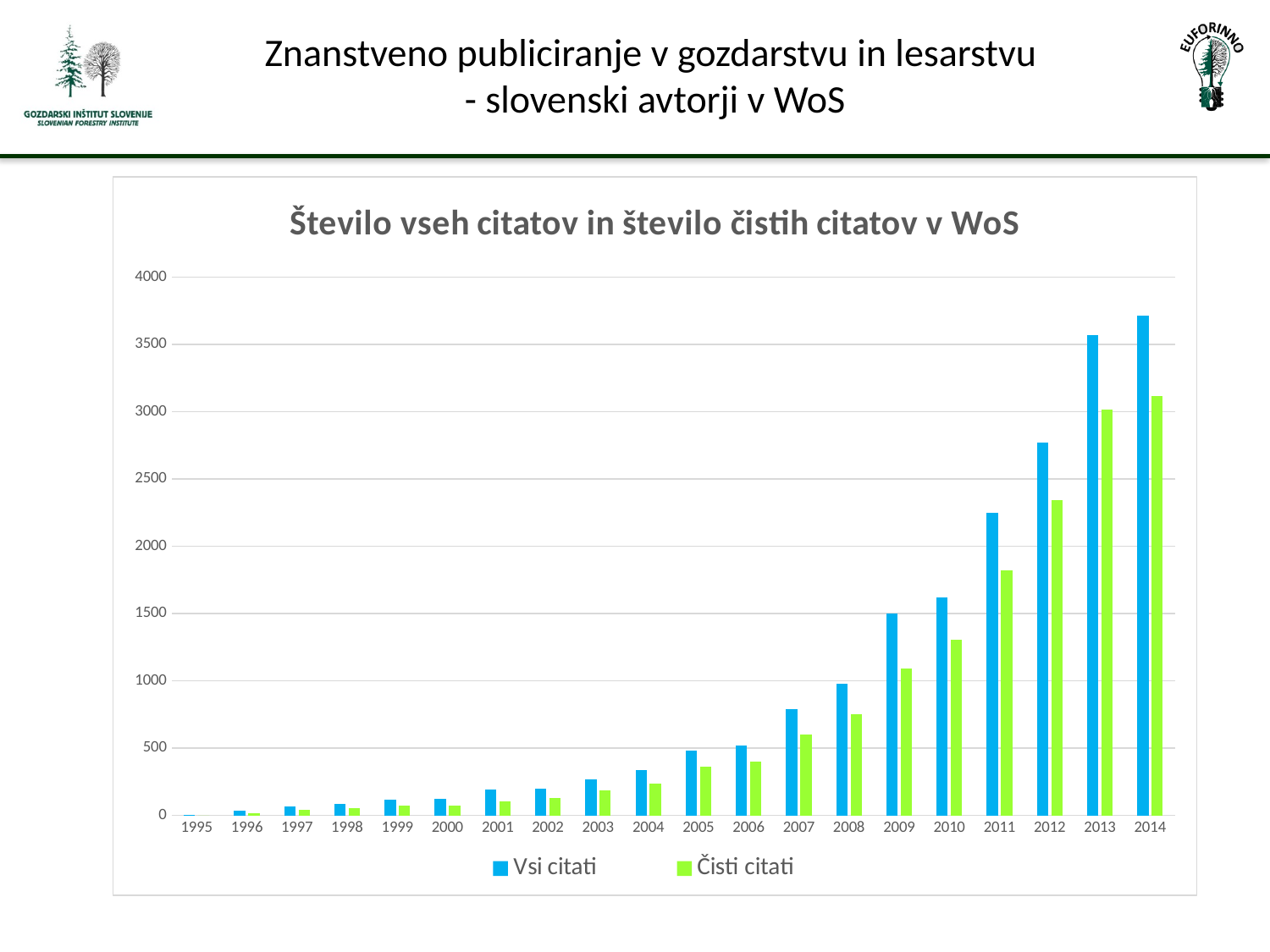
Which is larger in 2013, Vsi citati or Čisti citati? Vsi citati Which year has the highest value for Vsi citati? 2014 What kind of chart is shown on the slide? bar chart Is the value for Vsi citati in 2012 greater or less than 2500? greater Do the values for Vsi citati generally rise or fall from 1995 to 2014? rise How many series does the legend list? 2 What is the title of the chart? Število vseh citatov in število čistih citatov v WoS Is the value for Čisti citati in 2014 greater or less than 3000? greater How many years are shown on the x axis? 20 Is the value for Vsi citati in 2014 greater or less than 3500? greater Which year has the lowest value for Vsi citati? 1995